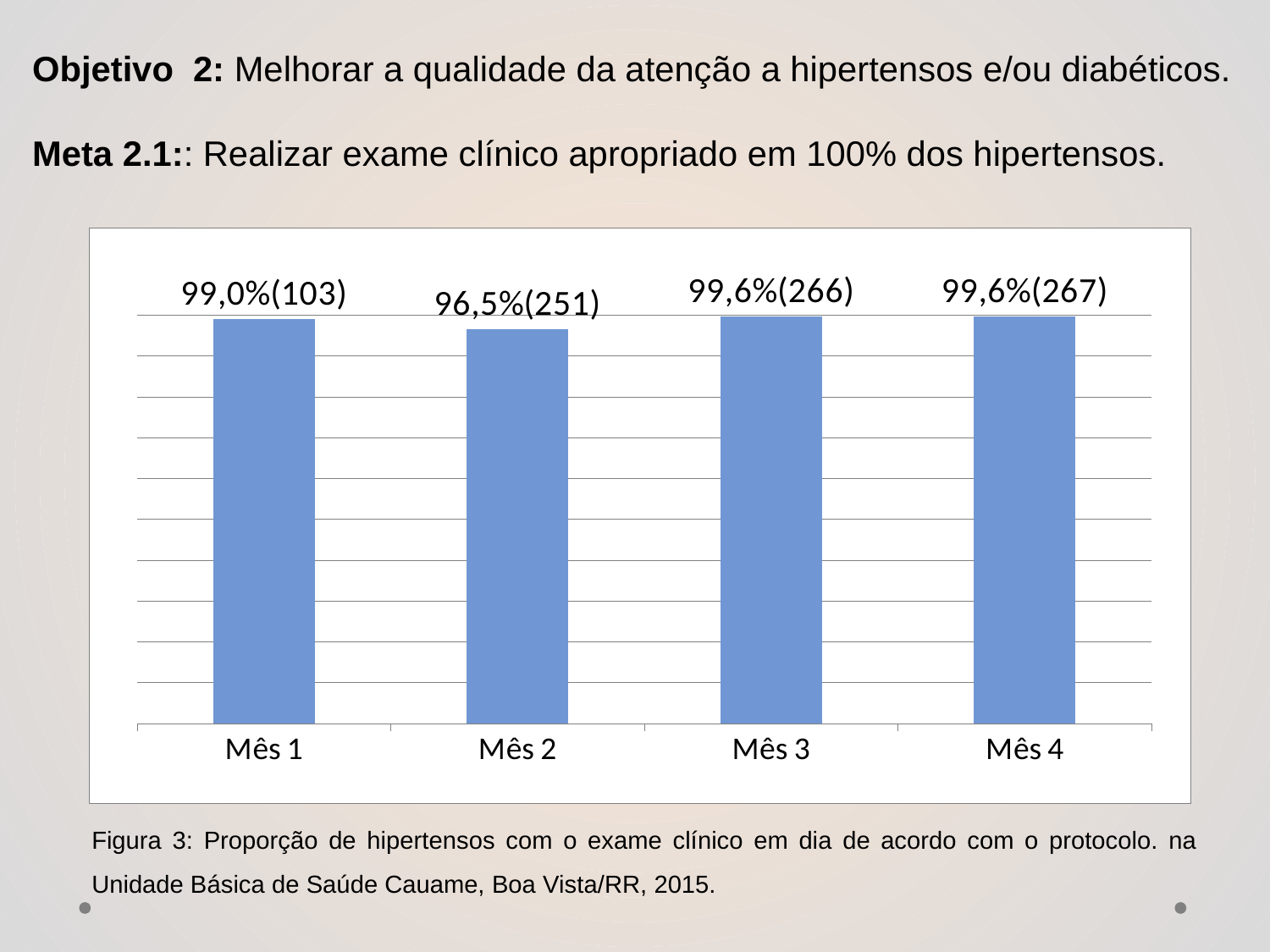
Does the proportion rise or fall from Mês 2 to Mês 3? Rise What value is shown for Mês 1? 99,0%(103) Does the proportion rise or fall from Mês 1 to Mês 2? Fall What kind of chart is shown on the slide? Bar chart Which is larger, the proportion for Mês 1 or for Mês 2? Mês 1 What value is shown for Mês 2? 96,5%(251) What value is shown for Mês 3? 99,6%(266) What figure number is given in the caption below the chart? Figura 3 What is the difference in percentage points between the proportion for Mês 1 and Mês 2? 2,5 What value is shown for Mês 4? 99,6%(267) How many months (categories) are shown on the chart? 4 Which month has the lowest proportion? Mês 2